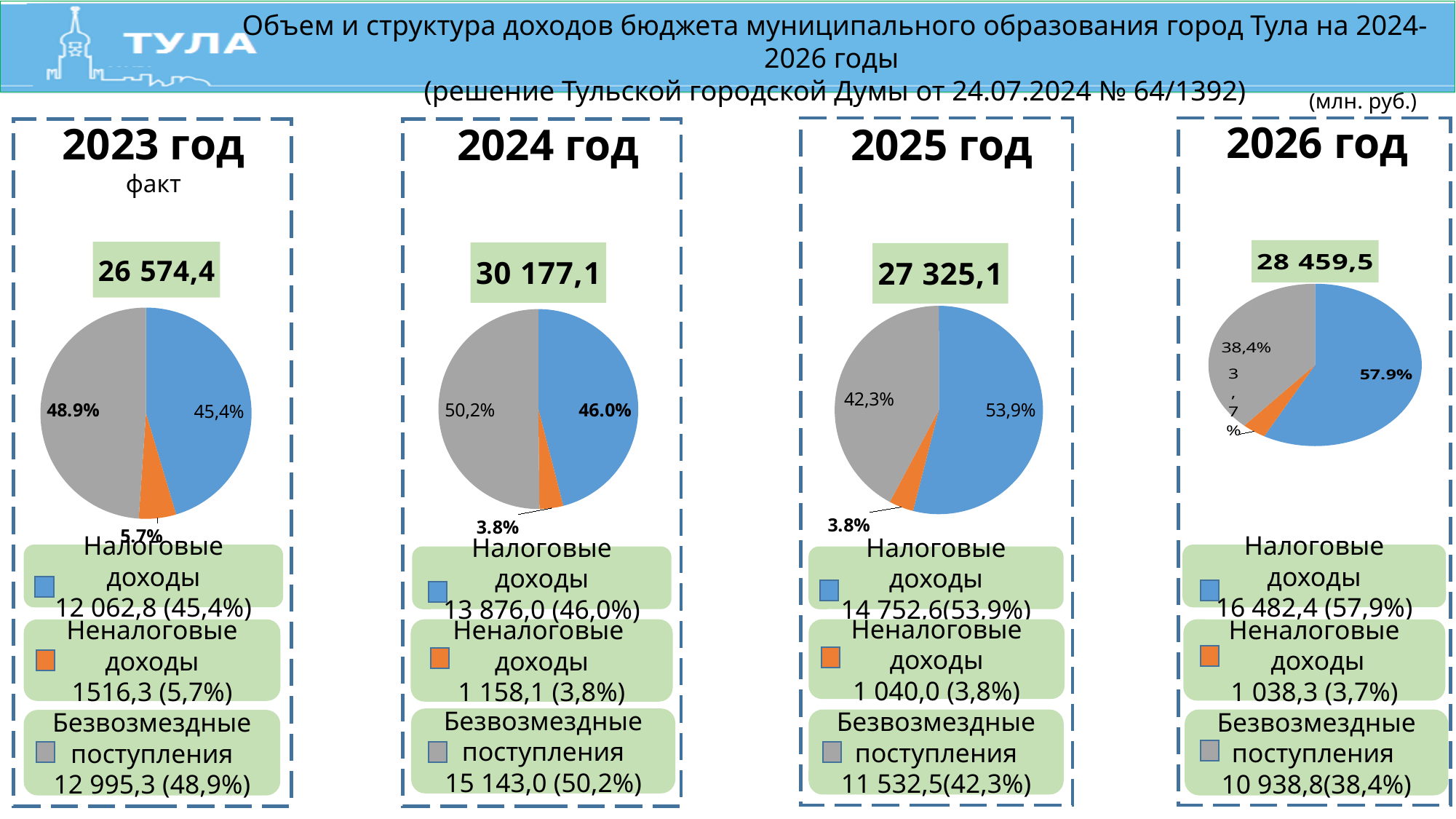
What colour represents Неналоговые доходы in the pie charts? Orange Does the share of Налоговые доходы rise or fall from the 2023 год chart to the 2026 год chart? Rises In the 2024 год chart, which is larger: Налоговые доходы or Безвозмездные поступления? Безвозмездные поступления In the 2025 год chart, what is the difference between Налоговые доходы and Безвозмездные поступления? 3 220,1 What total value is shown above the 2024 год pie chart? 30 177,1 In the 2026 год chart, what share of the pie is Неналоговые доходы? 3,7% In the 2024 год chart, which category has the smallest slice? Неналоговые доходы In the 2023 год chart, what share of the pie is Налоговые доходы? 45,4% How many slices does the 2025 год pie chart have? 3 What kind of chart is shown for 2024 год? Pie chart In the 2026 год chart, which category has the largest slice? Налоговые доходы In the 2025 год chart, what is the value for Безвозмездные поступления? 11 532,5